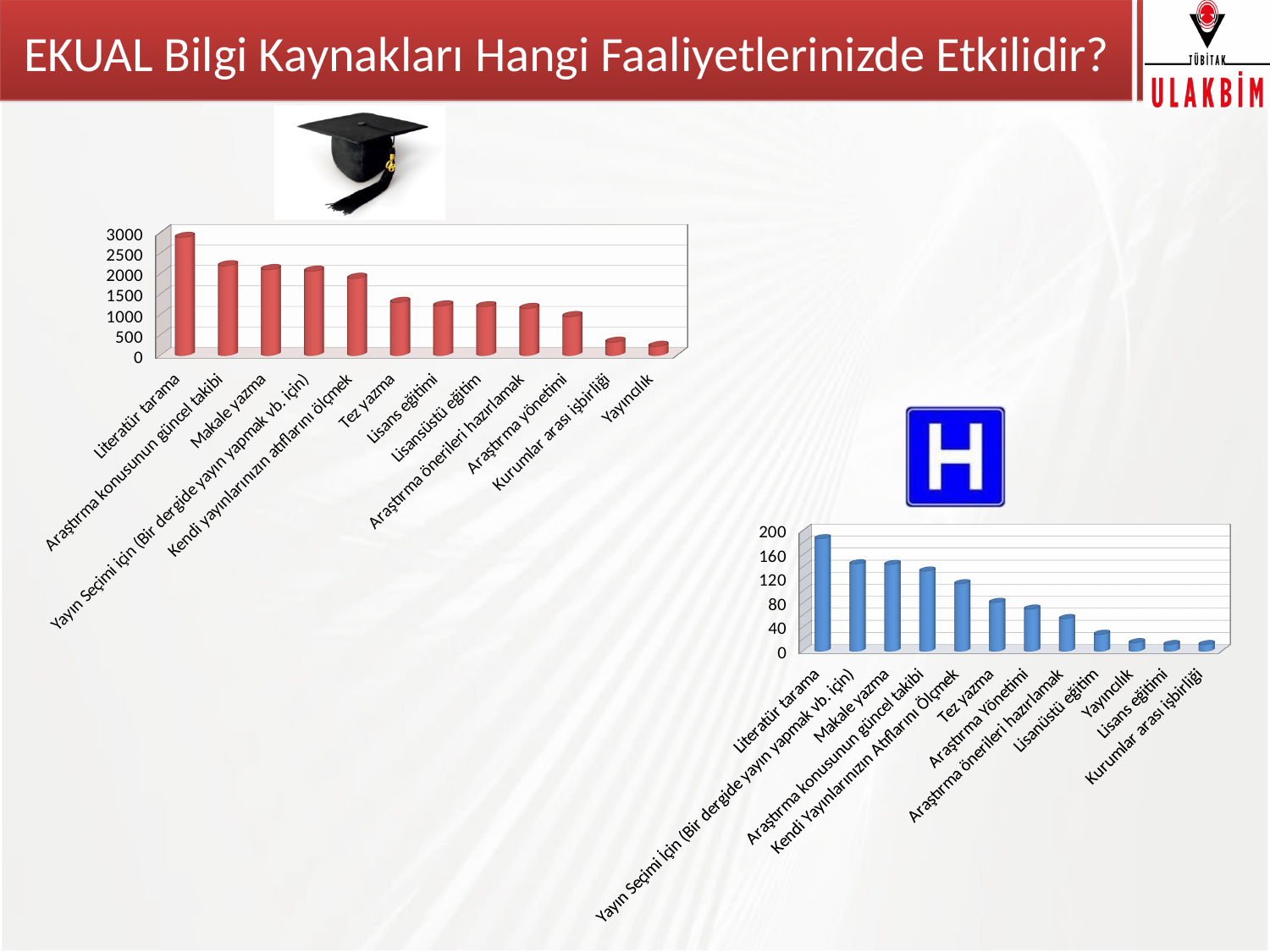
In the top-left chart with red bars, which category has the highest value? Literatür tarama In the bottom-right chart with blue bars, is the value for Literatür tarama greater or less than 160? greater In the bottom-right chart with blue bars, which is larger: Makale yazma or Tez yazma? Makale yazma How many categories are shown in the bottom-right chart with blue bars? 12 In the top-left chart with red bars, do the values rise or fall from left to right along the x axis? fall How many categories are shown in the top-left chart with red bars? 12 In the bottom-right chart with blue bars, which category has the highest value? Literatür tarama In the top-left chart with red bars, which is larger: Makale yazma or Tez yazma? Makale yazma In the top-left chart with red bars, is the value for Kurumlar arası işbirliği greater or less than 500? less In the bottom-right chart with blue bars, is the value for Yayıncılık greater or less than 40? less What type of chart is the top-left chart with red bars? bar chart